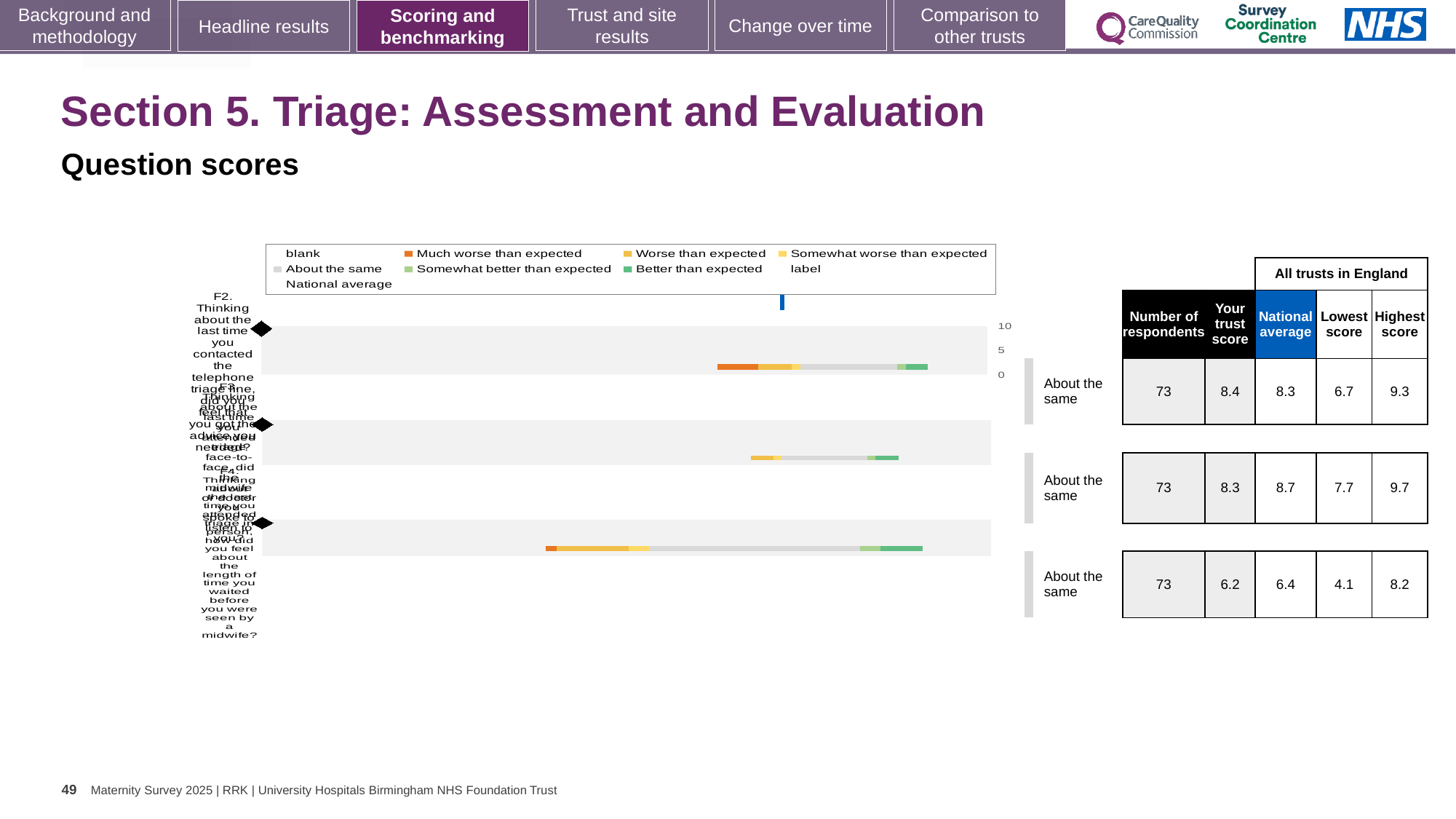
Which question row has the lowest trust score? the third row (F4) For the second question row (F3), which is larger: the trust score or the national average? the national average How many respondents are listed for the first question row (F2)? 73 What is the national average for the third question row (F4) in the table beside the chart? 6.4 What colour represents 'Better than expected' in the chart legend? green What type of chart is shown on the slide? bar chart Which question row has the highest trust score? the first row (F2) What is the lowest score among all trusts in England for the second question row (F3)? 7.7 What benchmark category is shown for all three question rows? About the same How many question rows (bars) are plotted in the chart? 3 What is the trust score for the first question row (F2) in the table beside the chart? 8.4 For the third question row (F4), what is the difference between the highest score and the lowest score? 4.1